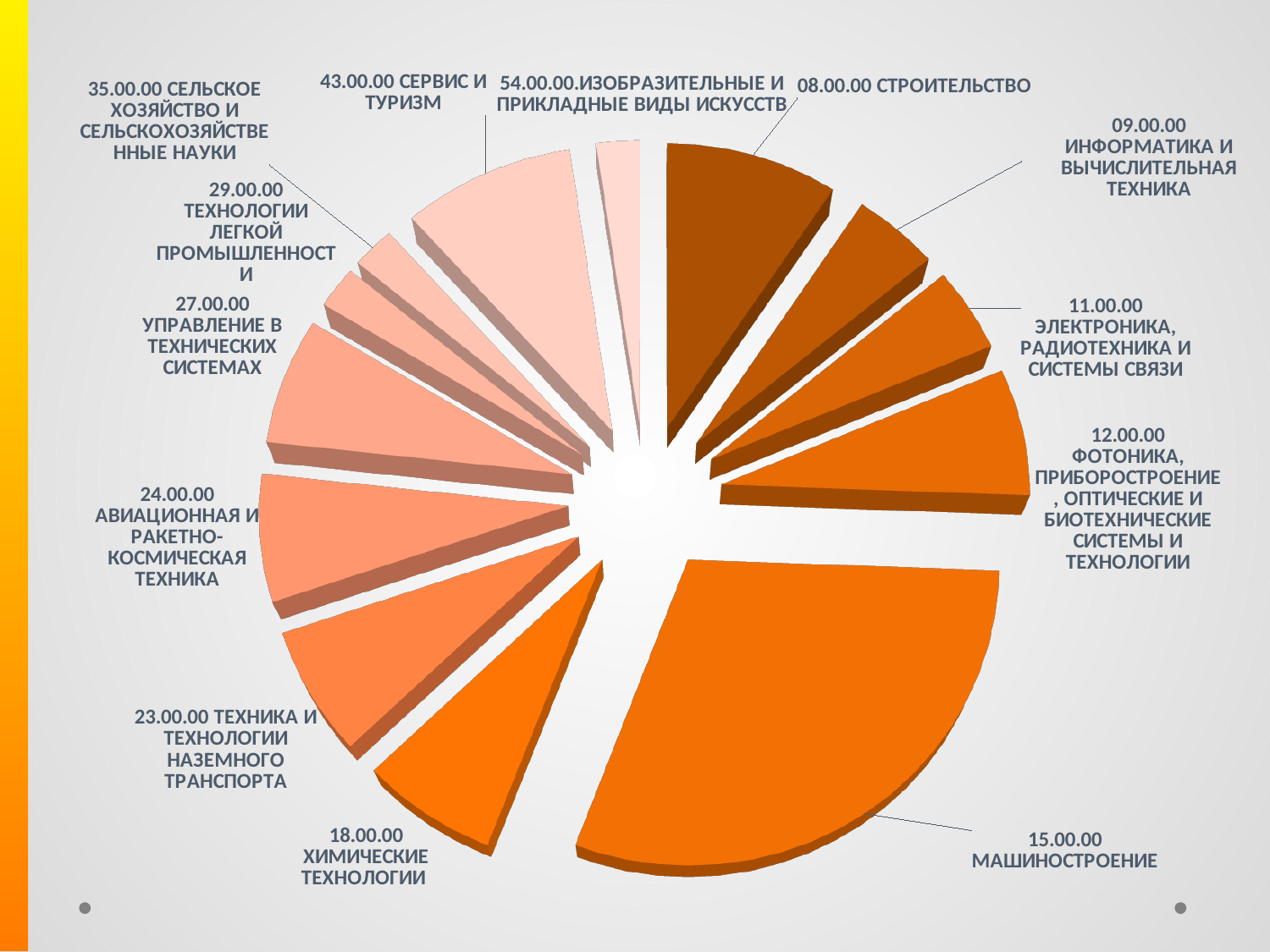
Is the pie chart drawn in 3D with the slices pulled apart (exploded), or as a flat pie? 3D exploded What kind of chart is shown on the slide? pie chart Which category has the largest slice of the pie chart? 15.00.00 МАШИНОСТРОЕНИЕ How many categories (slices) does the pie chart have? 13 Which slice is larger: 08.00.00 СТРОИТЕЛЬСТВО or 27.00.00 УПРАВЛЕНИЕ В ТЕХНИЧЕСКИХ СИСТЕМАХ? 08.00.00 СТРОИТЕЛЬСТВО Which slice is larger: 24.00.00 АВИАЦИОННАЯ И РАКЕТНО-КОСМИЧЕСКАЯ ТЕХНИКА or 54.00.00 ИЗОБРАЗИТЕЛЬНЫЕ И ПРИКЛАДНЫЕ ВИДЫ ИСКУССТВ? 24.00.00 АВИАЦИОННАЯ И РАКЕТНО-КОСМИЧЕСКАЯ ТЕХНИКА Which slice is larger: 18.00.00 ХИМИЧЕСКИЕ ТЕХНОЛОГИИ or 29.00.00 ТЕХНОЛОГИИ ЛЕГКОЙ ПРОМЫШЛЕННОСТИ? 18.00.00 ХИМИЧЕСКИЕ ТЕХНОЛОГИИ What is the code shown in the label for the category МАШИНОСТРОЕНИЕ? 15.00.00